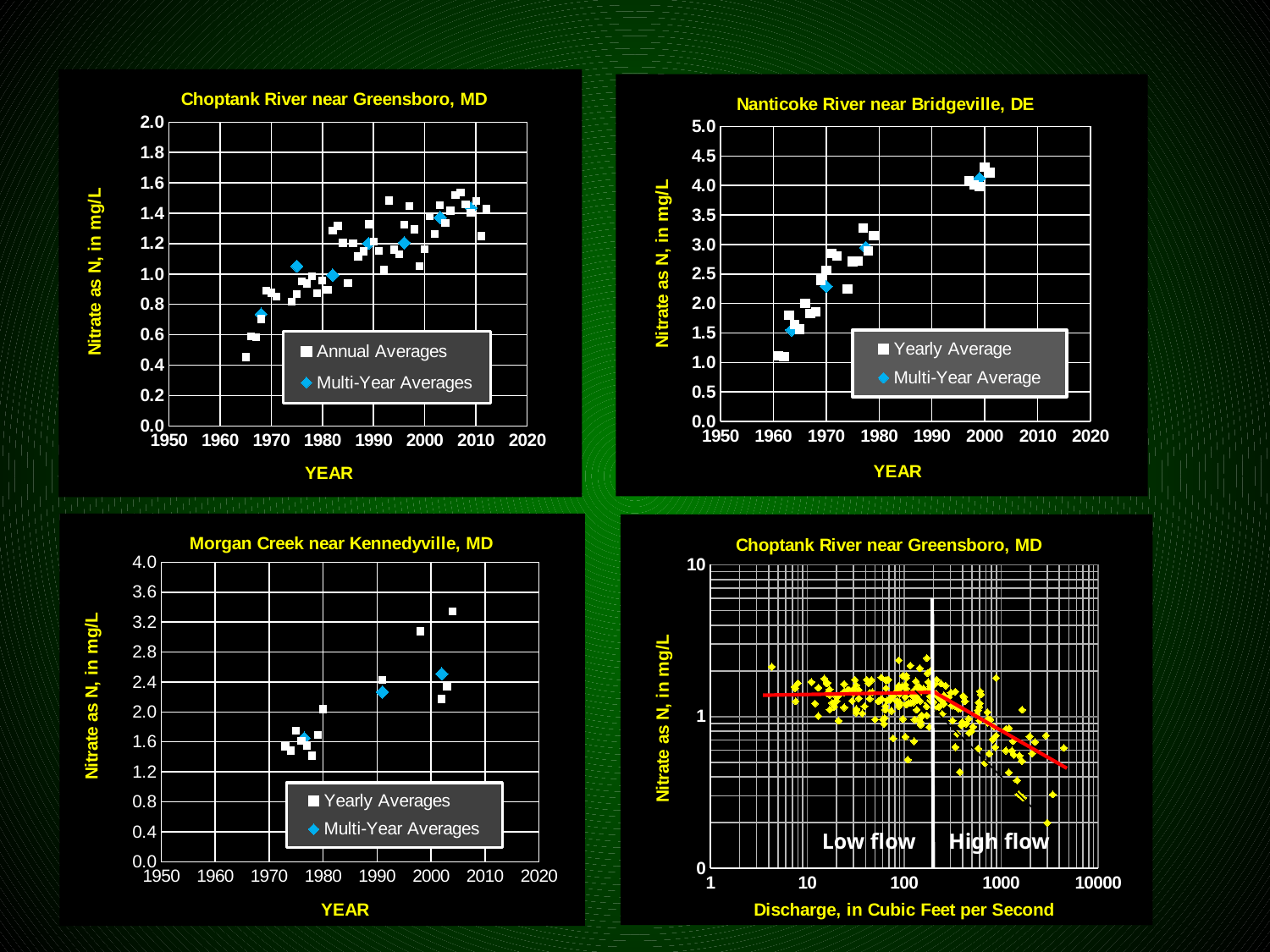
In the 'Nanticoke River near Bridgeville, DE' chart, do the nitrate values rise or fall over the years? rise What is the x-axis label of the bottom-right 'Choptank River near Greensboro, MD' chart? Discharge, in Cubic Feet per Second In the 'Nanticoke River near Bridgeville, DE' chart, is the Multi-Year Average value near 1964 greater or less than 2.0? less In the top-left 'Choptank River near Greensboro, MD' chart, is the Multi-Year Averages value near 1968 greater or less than 1.0? less In the 'Morgan Creek near Kennedyville, MD' chart, what are the two legend entries? Yearly Averages and Multi-Year Averages In the top-left 'Choptank River near Greensboro, MD' chart, do the annual average nitrate values generally rise or fall from 1965 to 2010? rise In the 'Nanticoke River near Bridgeville, DE' chart, how many Multi-Year Average points are plotted? 4 In the 'Morgan Creek near Kennedyville, MD' chart, how many Multi-Year Averages points are plotted? 3 How many series does the legend list in the 'Nanticoke River near Bridgeville, DE' chart? 2 In the 'Morgan Creek near Kennedyville, MD' chart, is the Multi-Year Averages value near 2002 greater or less than 2.0? greater In the bottom-right 'Choptank River near Greensboro, MD' chart, does the red trend line rise or fall as discharge increases in the 'High flow' region? fall What kind of chart is the 'Choptank River near Greensboro, MD' chart in the top-left of the slide? scatter chart